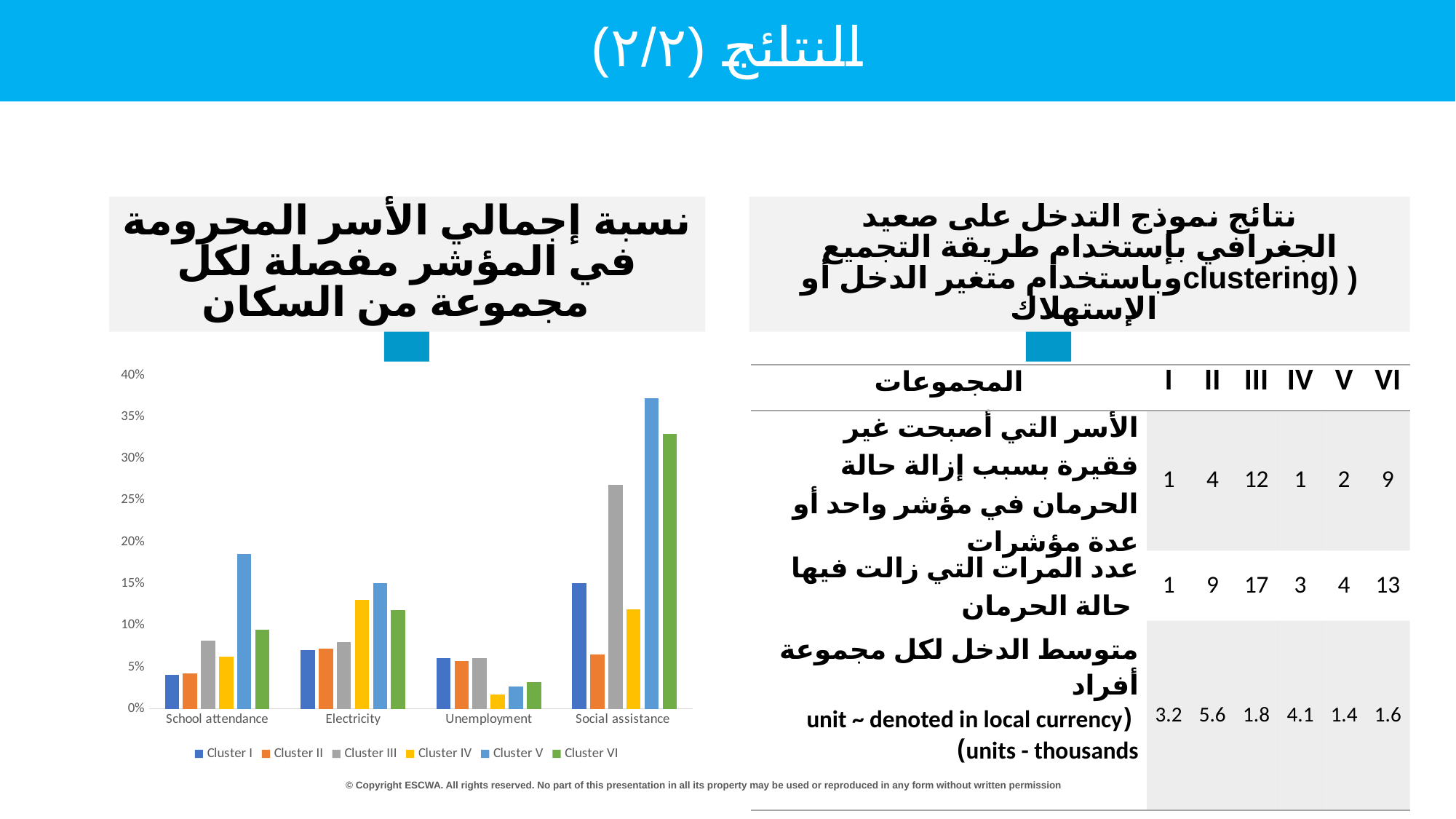
What kind of chart is shown on the left of the slide? bar chart Is the value for Cluster IV in Electricity greater or less than 10%? greater How many series does the legend of the bar chart list? 6 Is the value for Cluster V in Social assistance greater or less than 35%? greater In the bar chart, which cluster has the lowest bar for Unemployment? Cluster IV How many categories are shown on the x axis of the bar chart? 4 Is the value for Cluster V in School attendance greater or less than 15%? greater Which category in the bar chart contains the tallest bar overall? Social assistance In the bar chart, which cluster has the highest bar for School attendance? Cluster V In the bar chart, which cluster has the highest bar for Social assistance? Cluster V In the bar chart, which is larger for Electricity: Cluster V or Cluster I? Cluster V